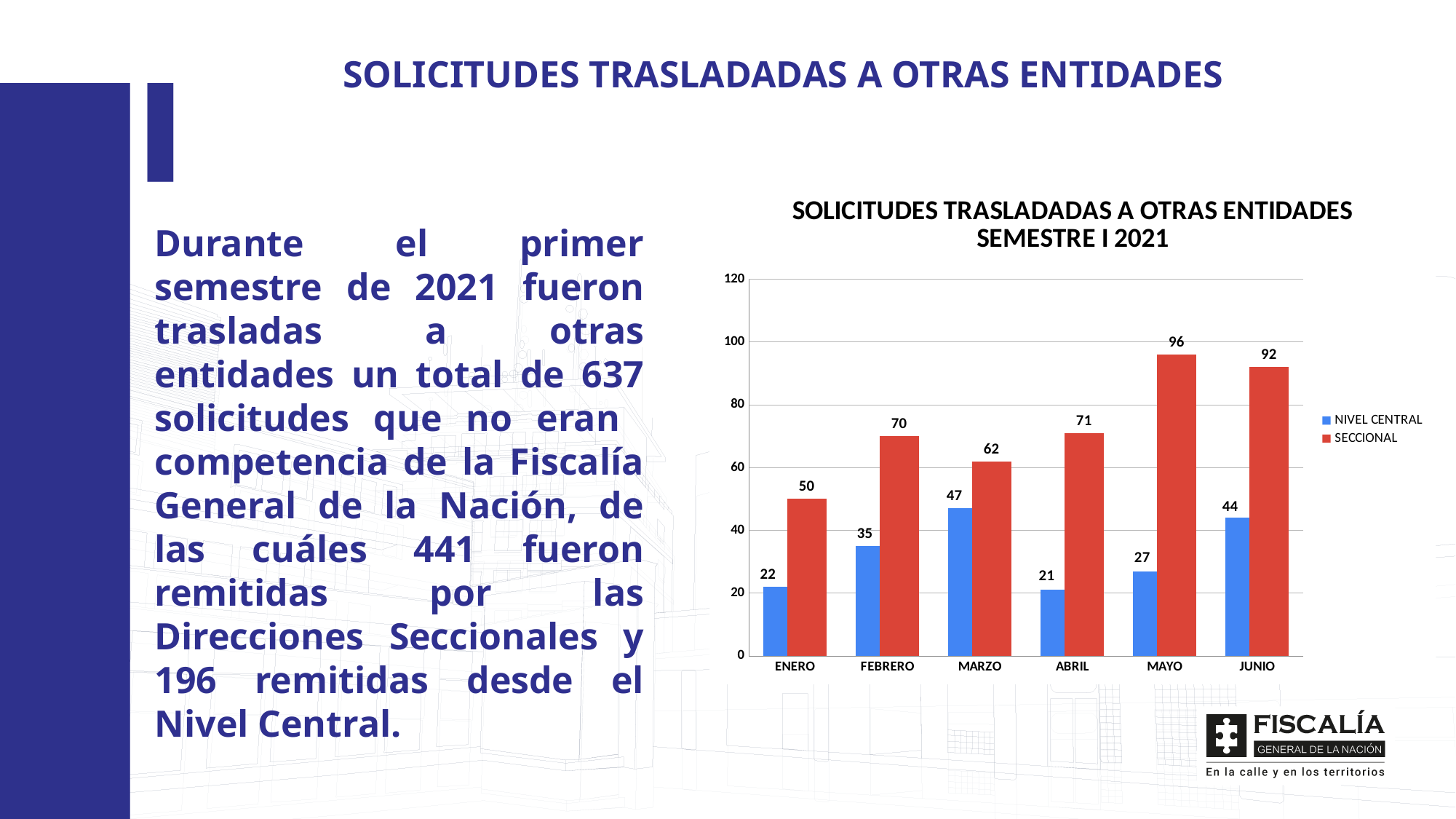
How many series does the legend list? 2 What is the value for NIVEL CENTRAL in MARZO? 47 What is the difference between the SECCIONAL and NIVEL CENTRAL values in JUNIO? 48 Which colour represents the SECCIONAL series? Red Is the SECCIONAL value for ABRIL greater or less than 60? greater Which month has the lowest NIVEL CENTRAL value? ABRIL What kind of chart is shown on the slide? Bar chart Which is larger in FEBRERO, NIVEL CENTRAL or SECCIONAL? SECCIONAL What is the value for SECCIONAL in ENERO? 50 What is the value for SECCIONAL in MAYO? 96 Which month has the highest SECCIONAL value? MAYO How many months are shown on the x axis? 6